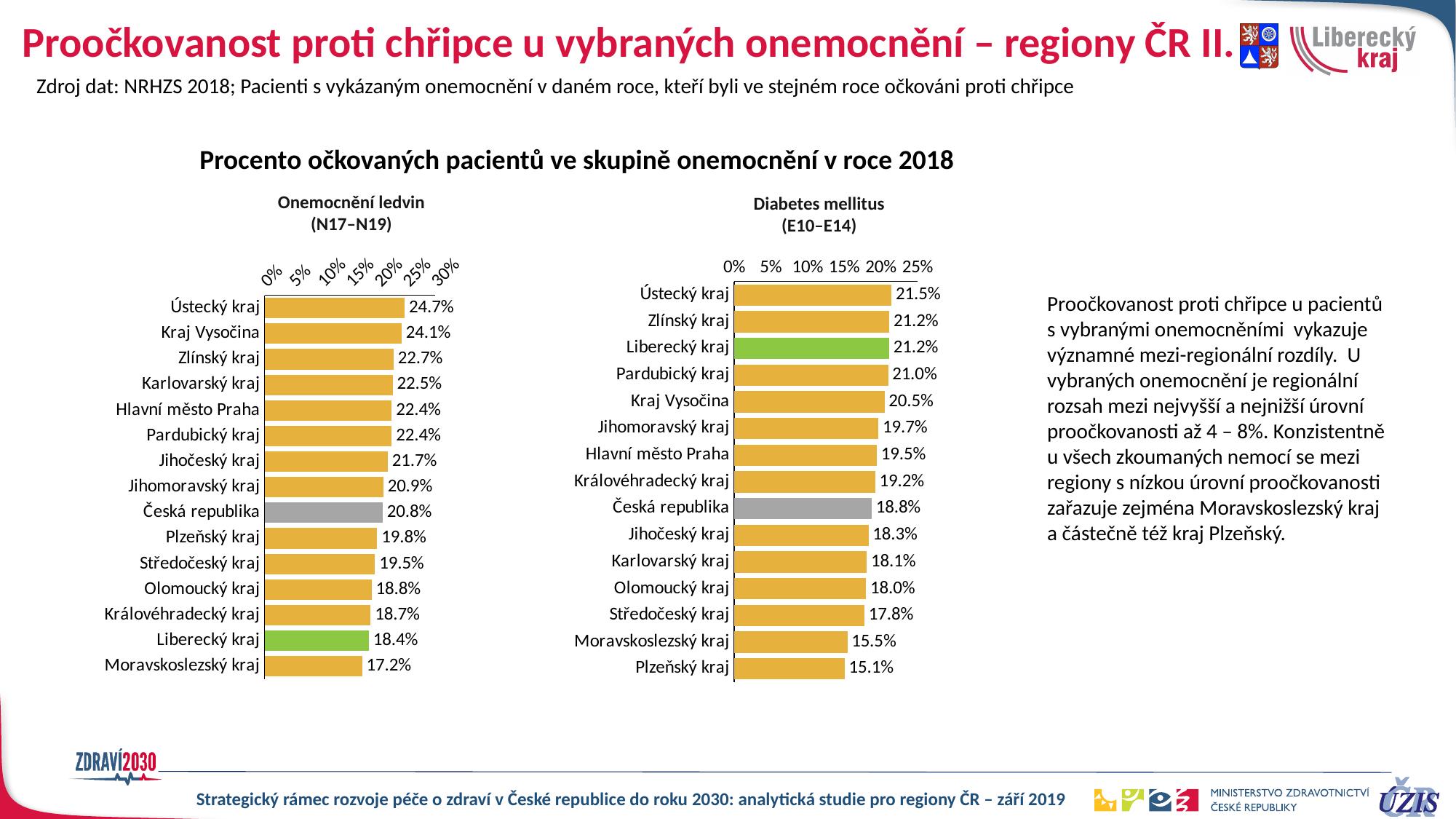
In the 'Onemocnění ledvin (N17–N19)' chart, is the value for Kraj Vysočina greater or less than 20%? greater In the 'Diabetes mellitus (E10–E14)' chart, which is larger: Kraj Vysočina or Jihomoravský kraj? Kraj Vysočina In the 'Diabetes mellitus (E10–E14)' chart, what is the difference between Ústecký kraj and Plzeňský kraj? 6.4% In the 'Onemocnění ledvin (N17–N19)' chart, which region has the highest value? Ústecký kraj In the 'Diabetes mellitus (E10–E14)' chart, which region has the lowest value? Plzeňský kraj How many bars are shown in the 'Diabetes mellitus (E10–E14)' chart? 15 In the 'Onemocnění ledvin (N17–N19)' chart, what is the value for Hlavní město Praha? 22.4% In the 'Onemocnění ledvin (N17–N19)' chart, what is the difference between Ústecký kraj and Moravskoslezský kraj? 7.5% In the 'Diabetes mellitus (E10–E14)' chart, which bar is coloured green? Liberecký kraj In the 'Diabetes mellitus (E10–E14)' chart, what is the value for Česká republika? 18.8% In the 'Onemocnění ledvin (N17–N19)' chart, what is the value for Liberecký kraj? 18.4% What type of chart is the 'Onemocnění ledvin (N17–N19)' chart? bar chart